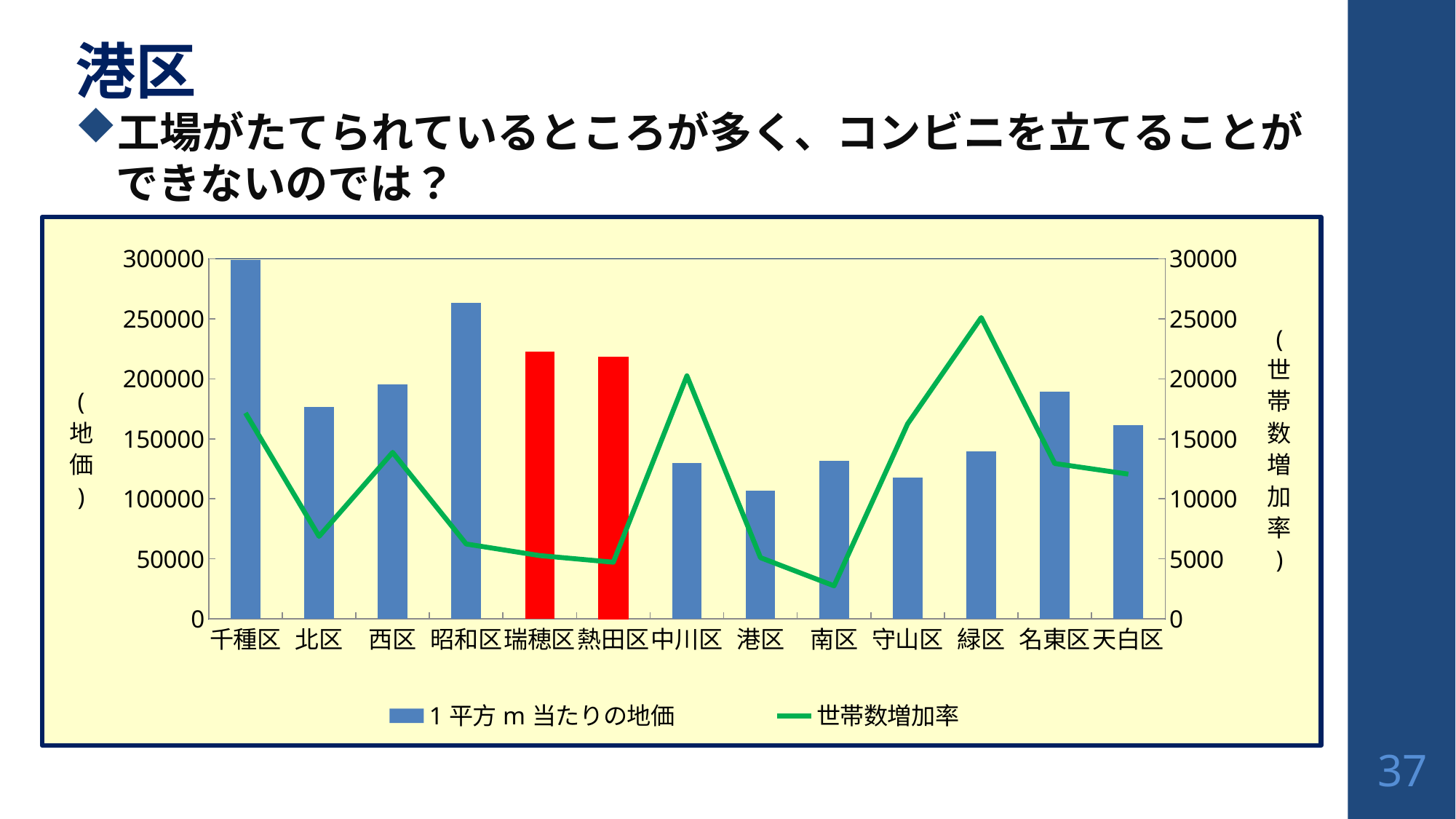
Which ward has the highest value on the 世帯数増加率 line? 緑区 Is the 1平方m当たりの地価 bar for 港区 greater or less than 150000? less Which two wards have their bars coloured red instead of blue? 瑞穂区 and 熱田区 Which ward has the lowest value on the 世帯数増加率 line? 南区 Which ward has the highest bar for 1平方m当たりの地価? 千種区 How many series does the chart's legend list? 2 Is the 1平方m当たりの地価 bar for 昭和区 greater or less than 250000? greater What kind of chart is shown on the slide? A combined bar and line chart Which ward has the larger 1平方m当たりの地価 bar, 西区 or 北区? 西区 Is the 世帯数増加率 value for 中川区 greater or less than 15000? greater How many wards (categories) are shown on the x axis of the chart? 13 Which ward has the lowest bar for 1平方m当たりの地価? 港区